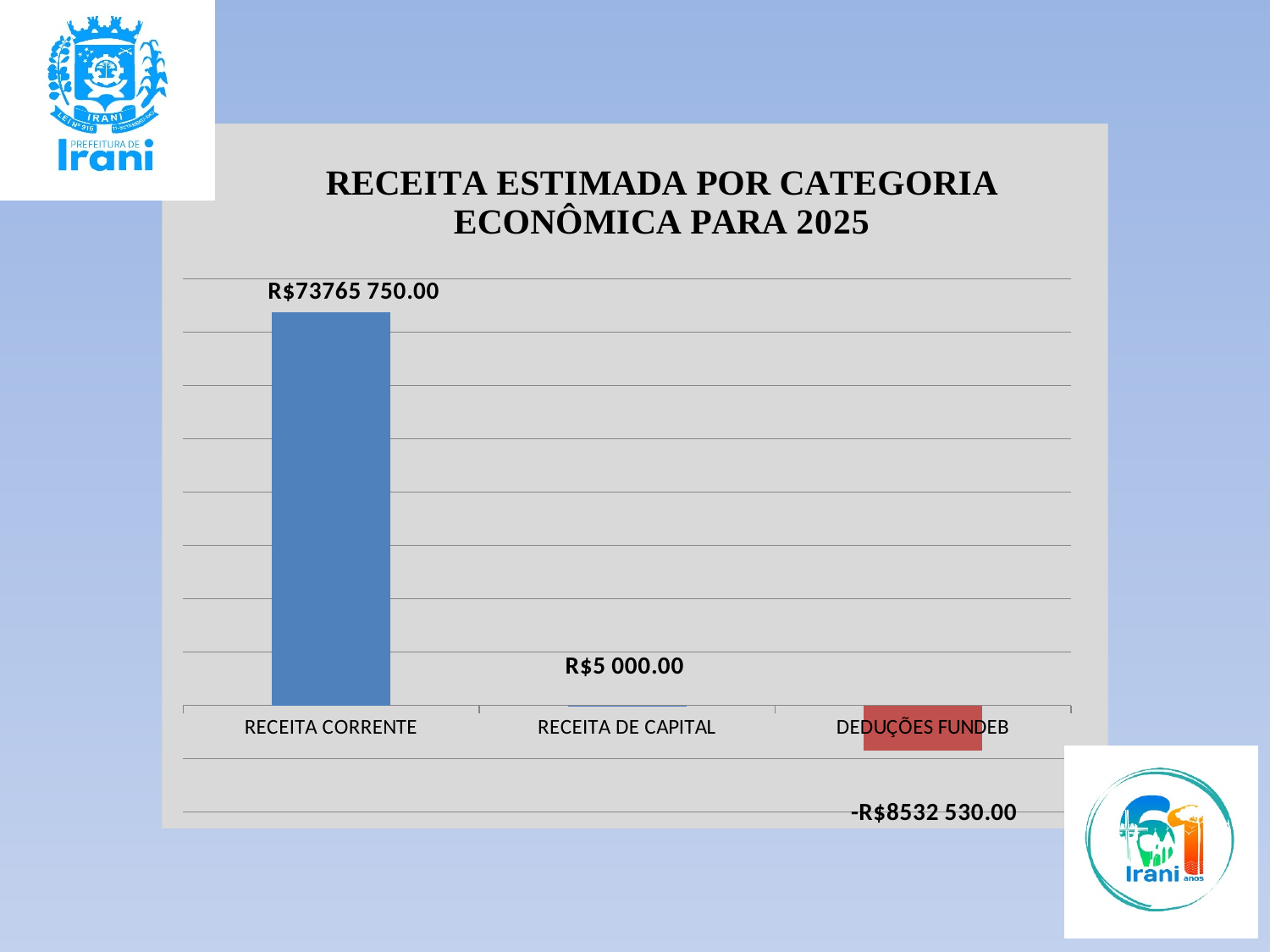
Which is larger, the value for RECEITA DE CAPITAL or the value for DEDUÇÕES FUNDEB? RECEITA DE CAPITAL What colour is the bar for DEDUÇÕES FUNDEB? Red What is the value for RECEITA DE CAPITAL? R$5 000.00 What is the title of the chart? RECEITA ESTIMADA POR CATEGORIA ECONÔMICA PARA 2025 What kind of chart is shown on the slide? Bar chart Which category has the highest value? RECEITA CORRENTE Which category has the lowest value? DEDUÇÕES FUNDEB How many categories are shown in the chart? 3 What is the difference between the values for RECEITA DE CAPITAL and DEDUÇÕES FUNDEB? R$8537 530.00 What is the difference between the values for RECEITA CORRENTE and RECEITA DE CAPITAL? R$73760 750.00 What is the value for DEDUÇÕES FUNDEB? -R$8532 530.00 What is the value for RECEITA CORRENTE? R$73765 750.00